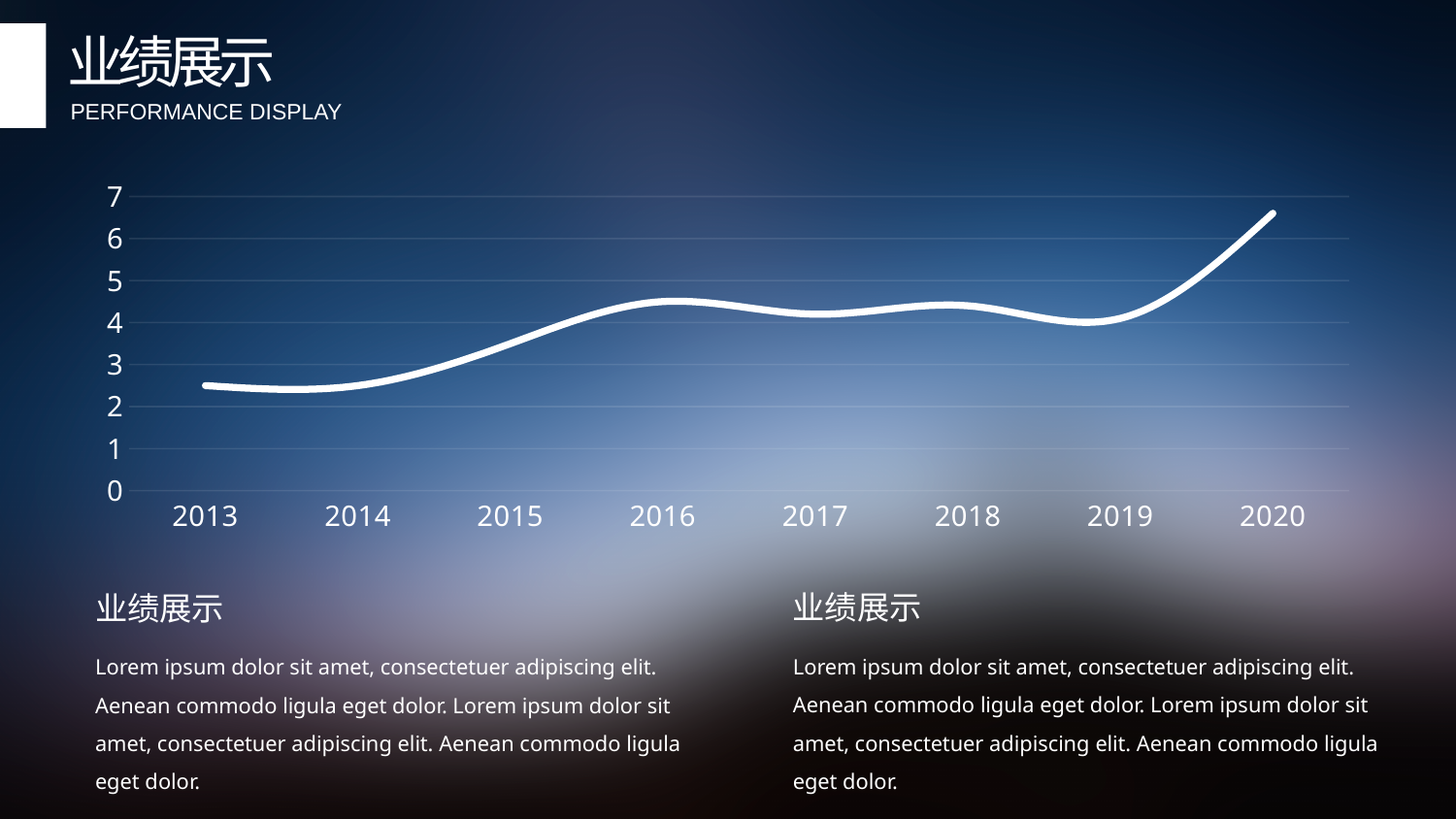
Does the line rise or fall between 2019 and 2020? rise What kind of chart is shown on the slide? line chart Is the value for 2015 greater or less than 4? less Which year has the highest value on the chart? 2020 Is the value for 2013 greater or less than 3? less Is the value for 2019 greater or less than 5? less What is the English subtitle shown under the slide title? PERFORMANCE DISPLAY How many years are shown on the x axis of the chart? 8 Which is larger, the value for 2020 or the value for 2013? 2020 Which is larger, the value for 2016 or the value for 2015? 2016